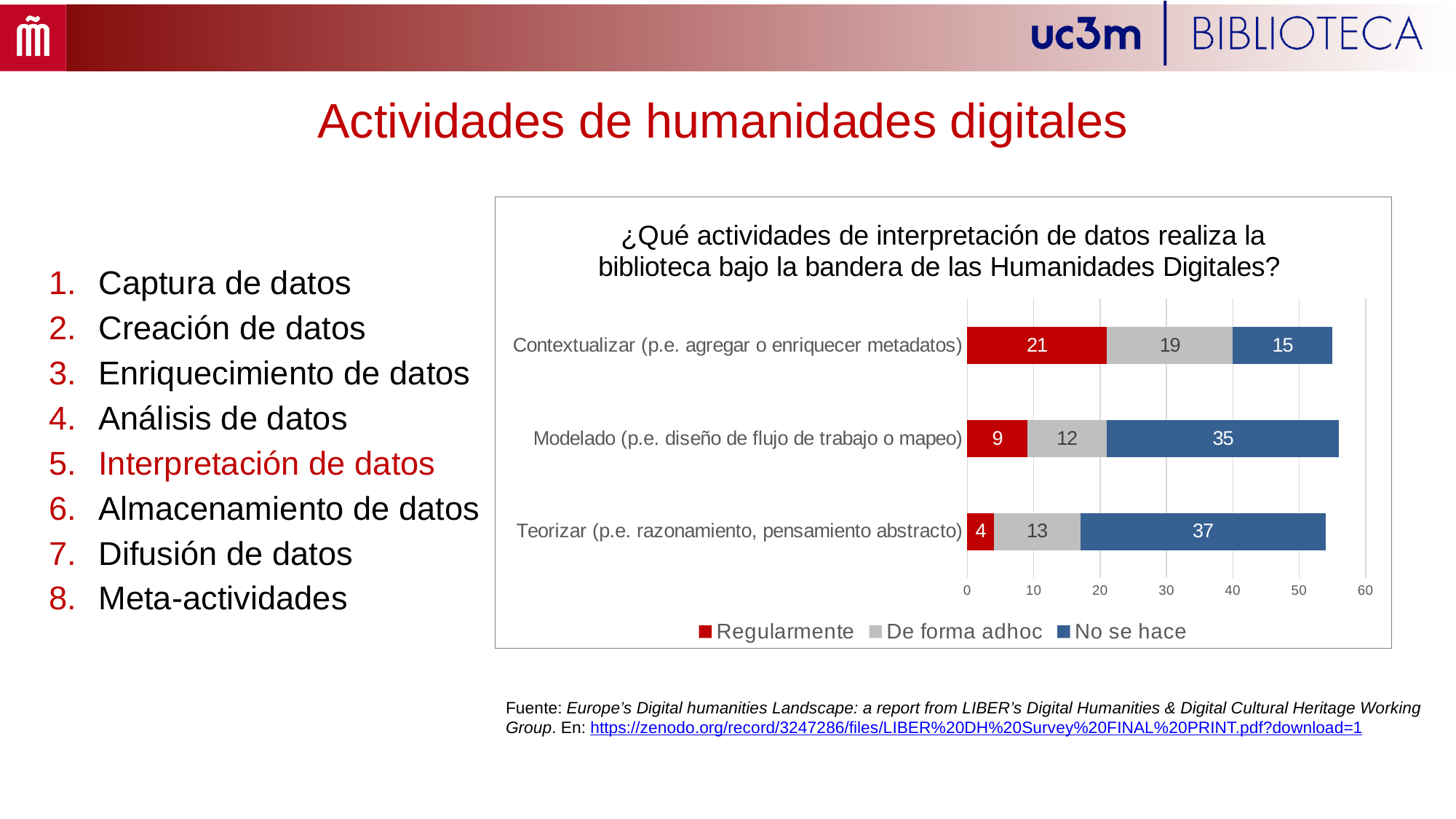
How many series does the chart legend list? 3 How many categories are plotted on the chart? 3 Which category has the lowest 'No se hace' value? Contextualizar (p.e. agregar o enriquecer metadatos) Which series is shown in red in the chart legend? Regularmente Which category has the highest 'Regularmente' value? Contextualizar (p.e. agregar o enriquecer metadatos) What is the total of the stacked bar for 'Contextualizar (p.e. agregar o enriquecer metadatos)'? 55 What is the 'Regularmente' value for 'Contextualizar (p.e. agregar o enriquecer metadatos)'? 21 What is the 'De forma adhoc' value for 'Modelado (p.e. diseño de flujo de trabajo o mapeo)'? 12 What is the 'No se hace' value for 'Teorizar (p.e. razonamiento, pensamiento abstracto)'? 37 What kind of chart is shown on the slide? Stacked bar chart Which is larger: the 'Regularmente' value for 'Modelado' or the 'Regularmente' value for 'Teorizar'? Modelado What is the difference between the 'No se hace' values for 'Teorizar' and 'Modelado'? 2